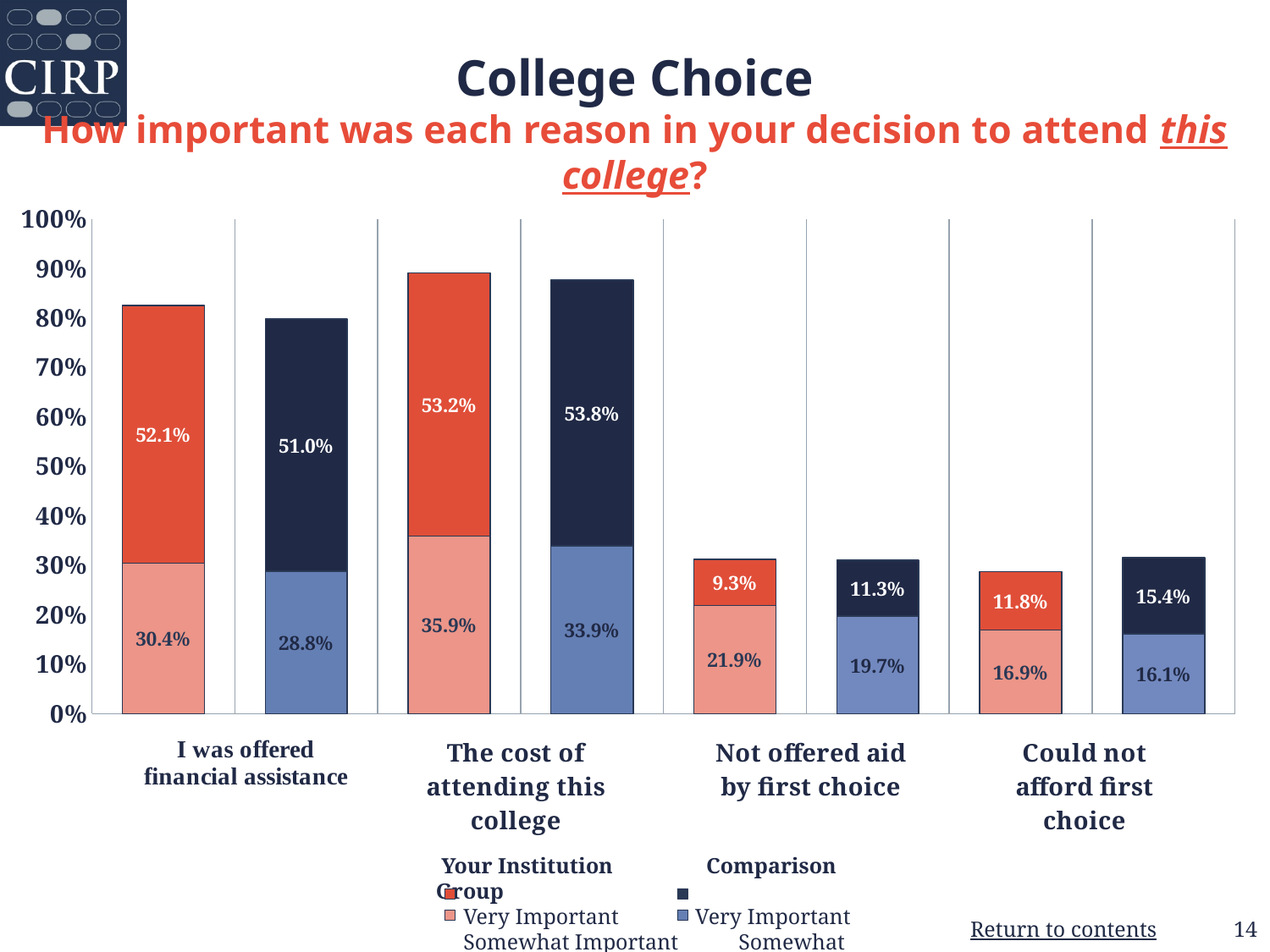
What percentage of the Comparison Group rated 'Not offered aid by first choice' as Somewhat Important? 19.7% How many reasons (categories) are shown on the x axis of the chart? 4 What percentage of students at Your Institution rated 'The cost of attending this college' as Very Important? 53.2% What is the difference between the Comparison Group and Your Institution Very Important values for 'Could not afford first choice'? 3.6 percentage points For Your Institution, which reason has the highest Very Important percentage? The cost of attending this college What type of chart is shown on the slide? Stacked bar chart What is the combined total (Very Important plus Somewhat Important) of the Your Institution bar for 'I was offered financial assistance'? 82.5% For Your Institution, which reason has the lowest Very Important percentage? Not offered aid by first choice For 'I was offered financial assistance', which group has the larger Somewhat Important percentage, Your Institution or the Comparison Group? Your Institution Is the total height of the Your Institution bar for 'The cost of attending this college' greater or less than 80%? greater What question does the chart's subtitle ask? How important was each reason in your decision to attend this college? What percentage of students at Your Institution rated 'Could not afford first choice' as Somewhat Important? 16.9%